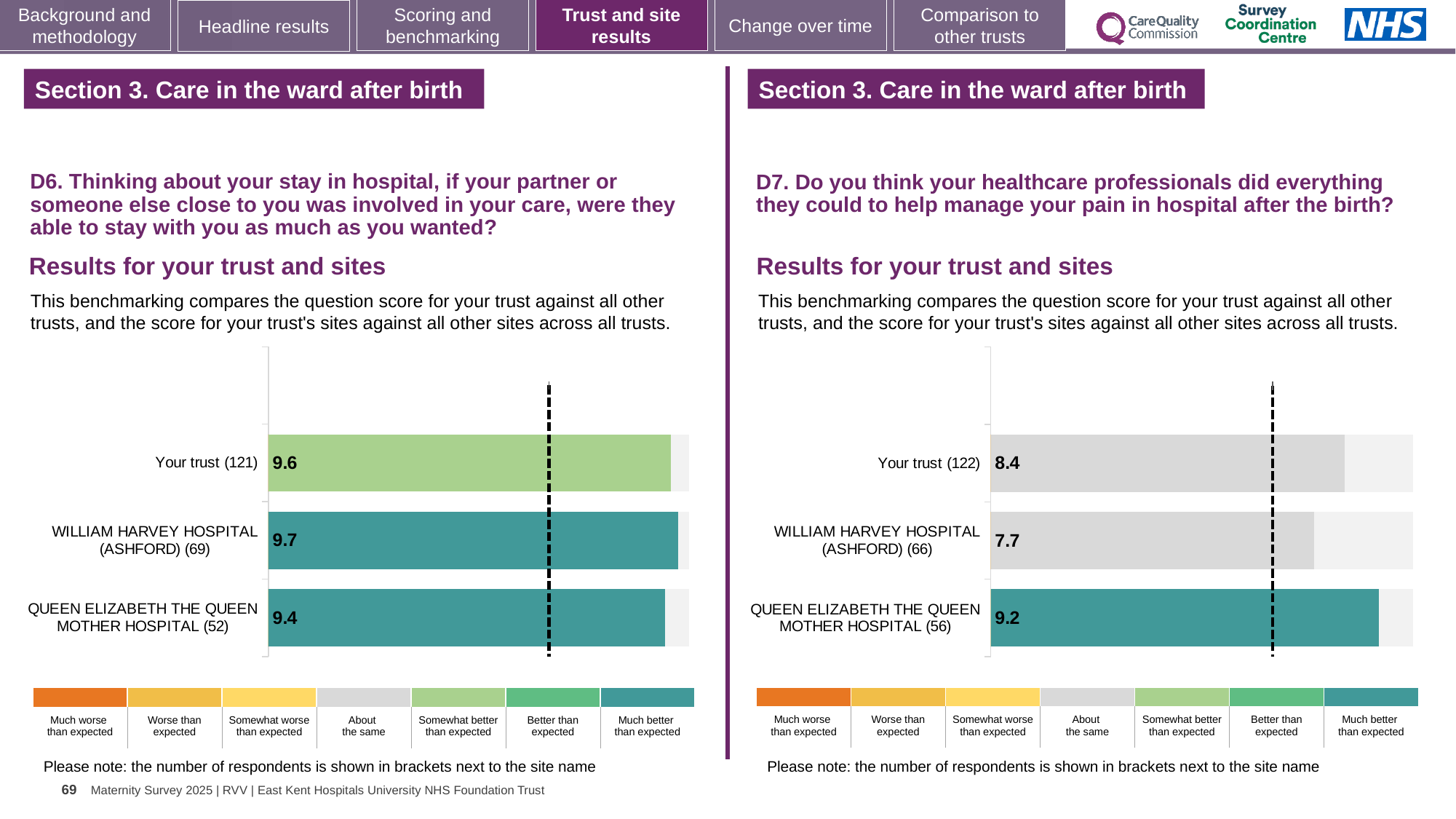
In the D6 chart on the left, which site or trust has the lowest score? QUEEN ELIZABETH THE QUEEN MOTHER HOSPITAL In the D7 chart on the right, what is the difference between the scores for QUEEN ELIZABETH THE QUEEN MOTHER HOSPITAL and WILLIAM HARVEY HOSPITAL (ASHFORD)? 1.5 In the D6 chart on the left, what is the score for Your trust? 9.6 In the D7 chart on the right, what is the score for QUEEN ELIZABETH THE QUEEN MOTHER HOSPITAL? 9.2 How many bars are shown in the D6 chart on the left? 3 In the D6 chart on the left, what is the score for WILLIAM HARVEY HOSPITAL (ASHFORD)? 9.7 In the D7 chart on the right, which has the larger score: Your trust or WILLIAM HARVEY HOSPITAL (ASHFORD)? Your trust In the D7 chart on the right, which site or trust has the highest score? QUEEN ELIZABETH THE QUEEN MOTHER HOSPITAL What type of chart is used for the D7 results on the right? Bar chart In the D7 chart on the right, what is the score for WILLIAM HARVEY HOSPITAL (ASHFORD)? 7.7 In the D7 chart on the right, how many respondents are shown in brackets for Your trust? 122 In the D6 chart on the left, what is the difference between the scores for WILLIAM HARVEY HOSPITAL (ASHFORD) and QUEEN ELIZABETH THE QUEEN MOTHER HOSPITAL? 0.3